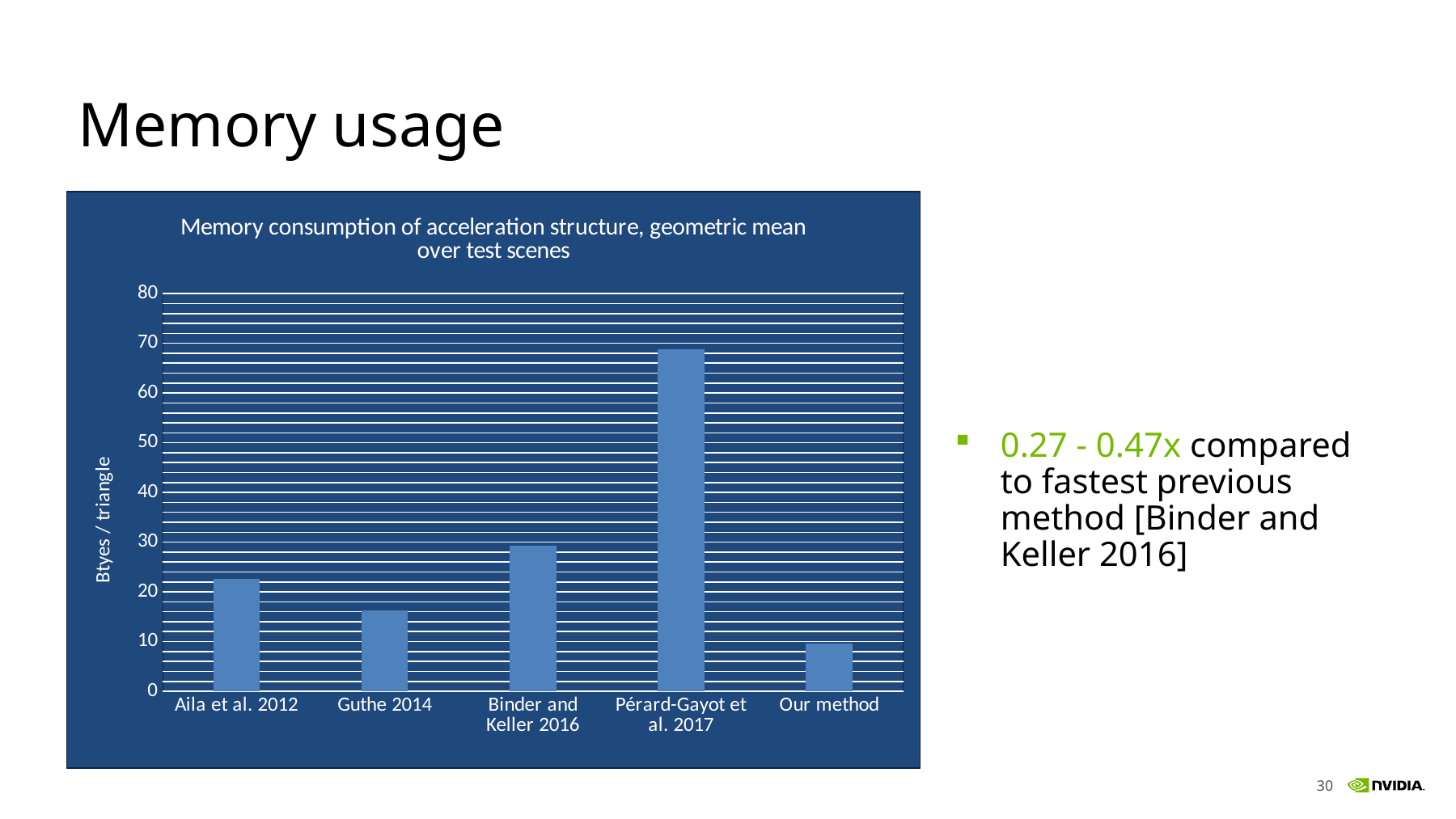
Is the value for Guthe 2014 greater or less than 20? less Which uses more memory per triangle, Aila et al. 2012 or Guthe 2014? Aila et al. 2012 How many methods (categories) are plotted on the x axis? 5 Is the value for Pérard-Gayot et al. 2017 greater or less than 60? greater What is the label of the y axis? Btyes / triangle Is the value for Aila et al. 2012 greater or less than 20? greater Which method has the lowest memory consumption? Our method Which method has the highest memory consumption? Pérard-Gayot et al. 2017 What is the title of the chart? Memory consumption of acceleration structure, geometric mean over test scenes Which uses more memory per triangle, Binder and Keller 2016 or Our method? Binder and Keller 2016 What kind of chart is shown on the slide? bar chart